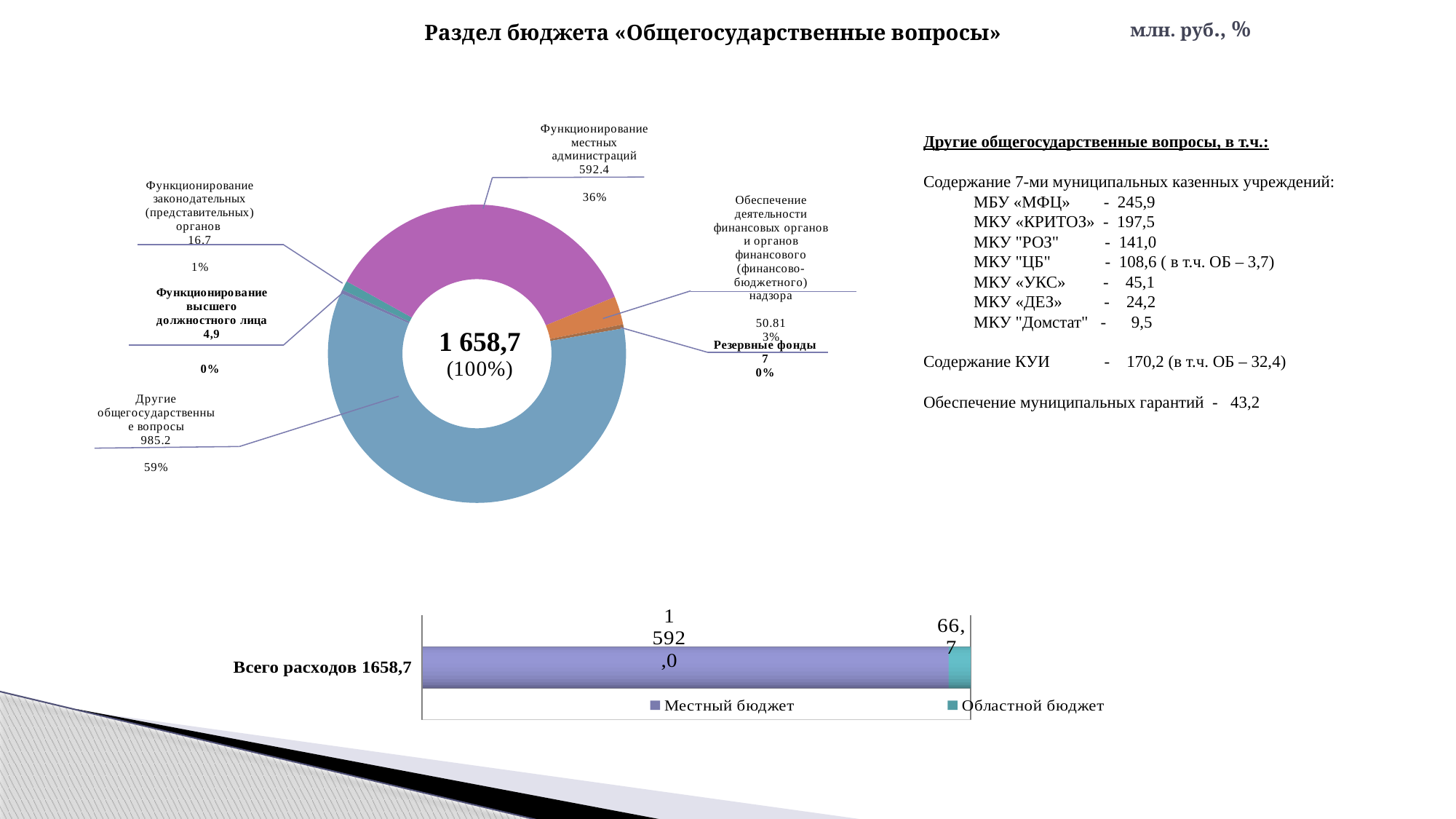
In the doughnut chart, how many categories are shown? 6 In the bottom bar chart, what value is shown for «Областной бюджет»? 66,7 In the doughnut chart, what value is shown for «Другие общегосударственные вопросы»? 985.2 In the doughnut chart, what percentage share is shown for «Функционирование местных администраций»? 36% In the bottom bar chart, how many series does the legend list? 2 In the bottom bar chart, what value is shown for «Местный бюджет»? 1 592,0 In the doughnut chart, which is larger: «Функционирование местных администраций» or «Обеспечение деятельности финансовых органов»? Функционирование местных администраций In the doughnut chart, what percentage share is shown for «Функционирование законодательных (представительных) органов»? 1% In the doughnut chart, what value is shown for «Резервные фонды»? 7 In the doughnut chart, which category has the largest share? Другие общегосударственные вопросы In the doughnut chart, which category has the smallest value? Функционирование высшего должностного лица In the doughnut chart, what total is shown in the centre? 1 658,7